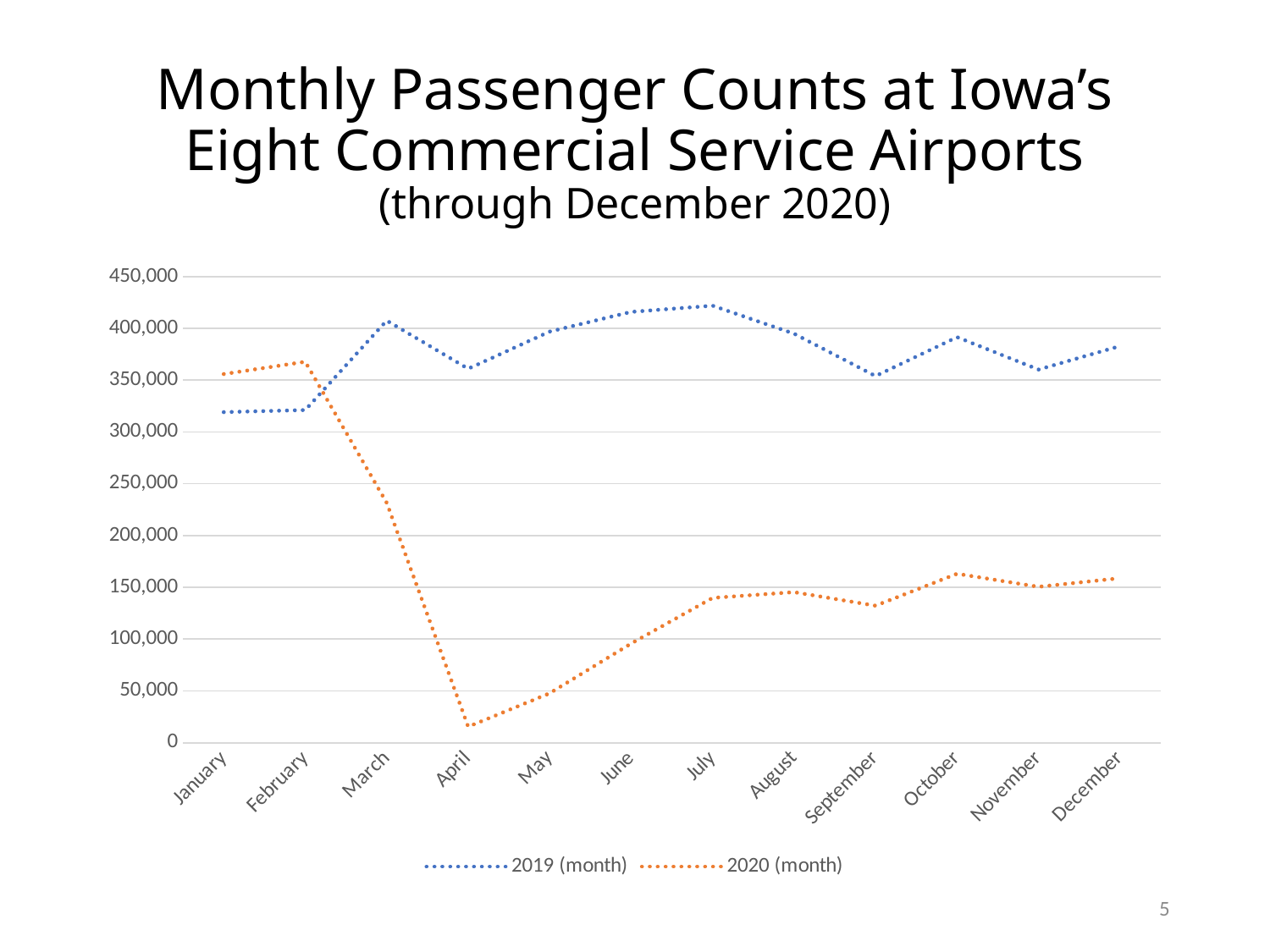
Does the 2020 (month) series rise or fall from April to July? Rise Which series has the larger value in January, 2019 (month) or 2020 (month)? 2020 (month) Is the value for 2020 (month) in April greater or less than 50,000? less In which month does the 2020 (month) series reach its lowest value? April In which month does the 2019 (month) series reach its highest value? July Is the value for 2020 (month) in September greater or less than 150,000? less Is the value for 2019 (month) in July greater or less than 400,000? greater What kind of chart is shown on the slide? Line chart How many months are plotted along the x axis? 12 How many series does the legend list? 2 What are the two entries listed in the legend? 2019 (month) and 2020 (month)